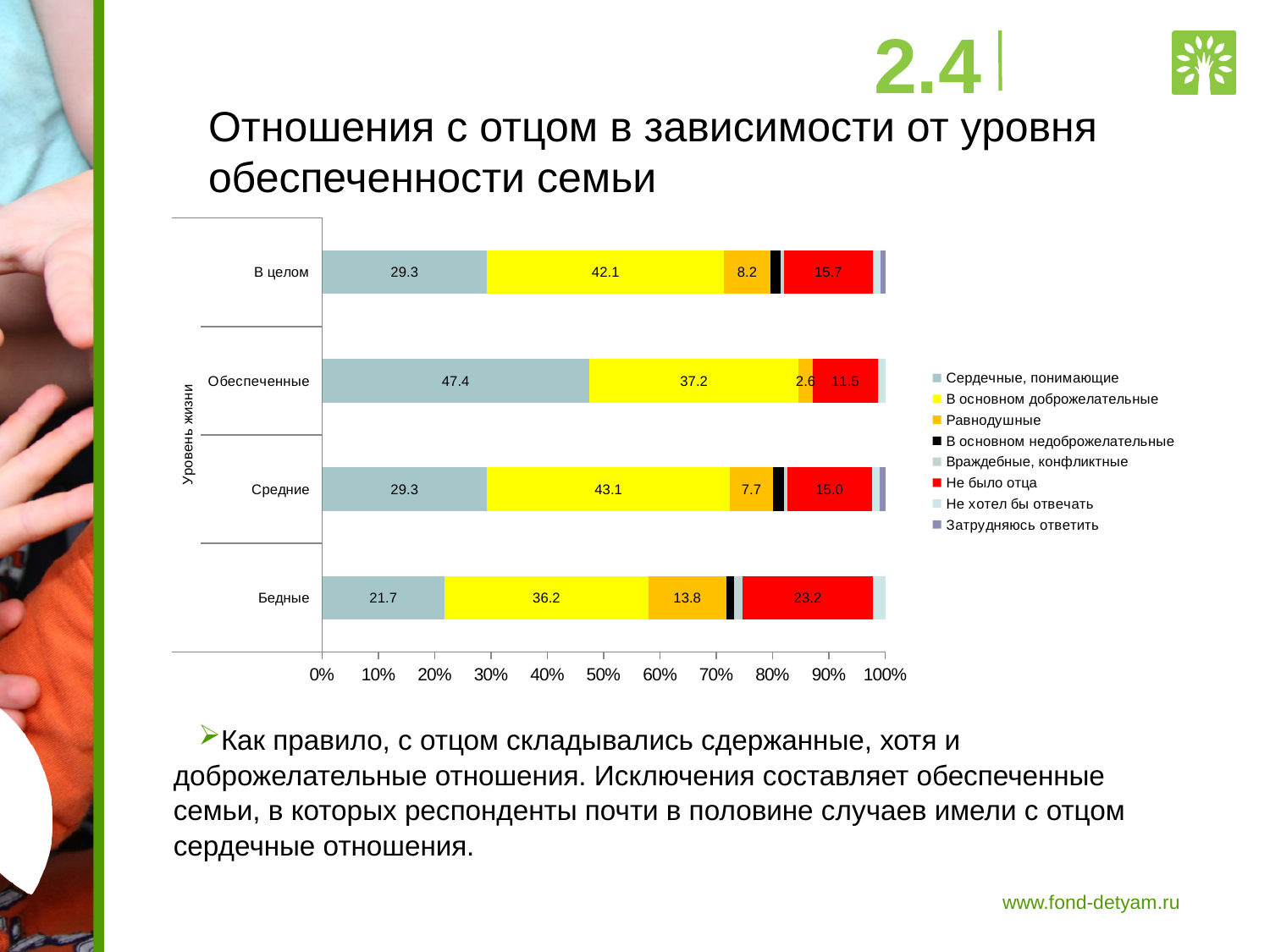
What is the value for "Сердечные, понимающие" in the "Обеспеченные" category? 47.4 How many categories are shown on the vertical axis of the chart? 4 How many series does the legend list? 8 What is the value for "Не было отца" in the "Бедные" category? 23.2 What is the value for "Равнодушные" in the "В целом" category? 8.2 What is the label of the vertical axis of the chart? Уровень жизни Which category has the highest value for "Сердечные, понимающие"? Обеспеченные Which is larger: the "Равнодушные" value for "Бедные" or for "Средние"? Бедные What is the difference between the "Не было отца" values for "Бедные" and "Обеспеченные"? 11.7 What is the value for "В основном доброжелательные" in the "Средние" category? 43.1 What kind of chart is shown on the slide? Stacked bar chart Which category has the lowest value for "Равнодушные"? Обеспеченные